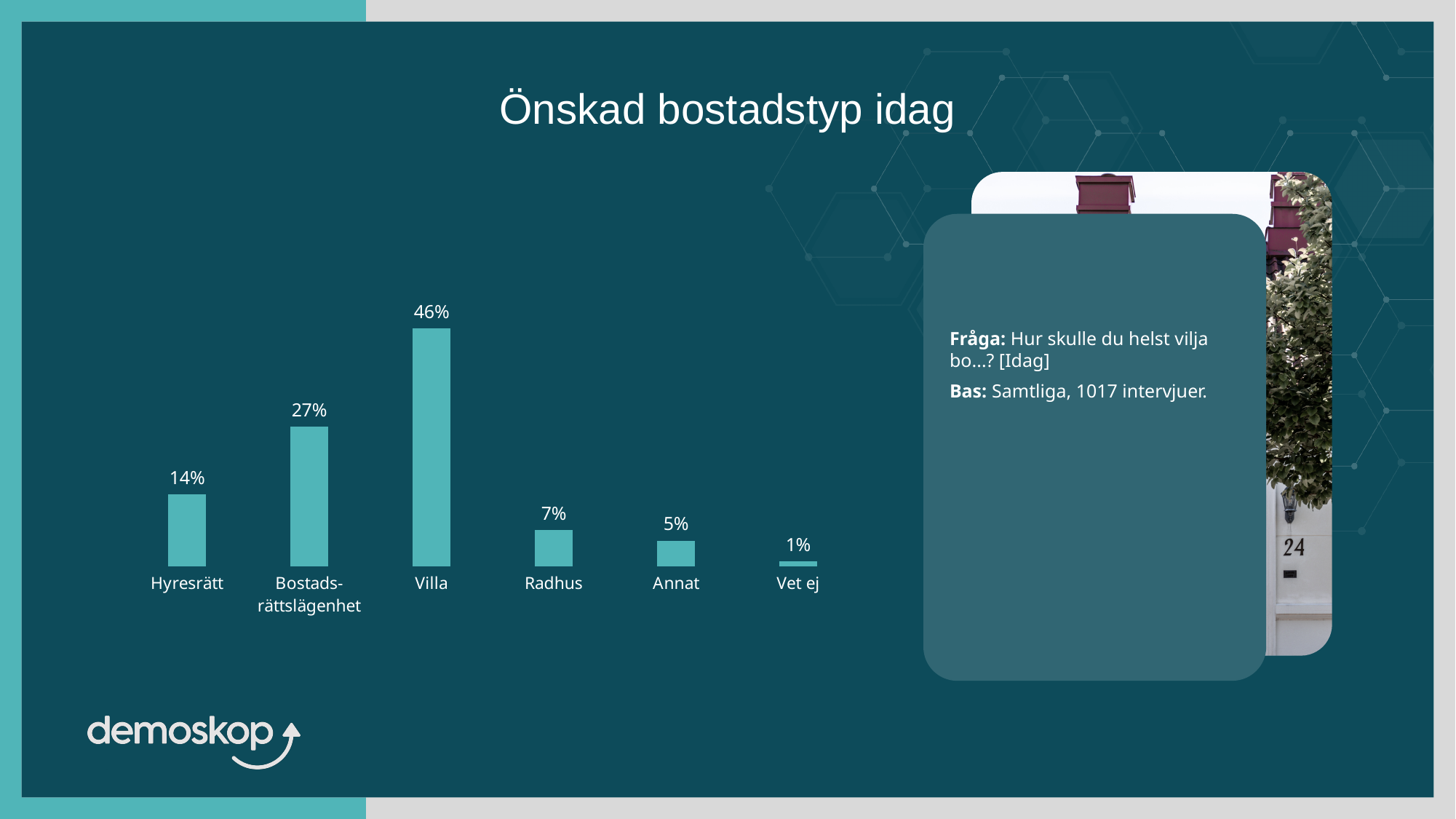
What is the value for Villa? 46% What is the title of the chart? Önskad bostadstyp idag Which category has the highest value? Villa What is the value for Bostadsrättslägenhet? 27% What is the value for Radhus? 7% What is the value for Hyresrätt? 14% Which category has the lowest value? Vet ej How many categories are shown in the chart? 6 What is the difference between the values for Villa and Bostadsrättslägenhet? 19 percentage points Which is larger, the value for Radhus or the value for Annat? Radhus What kind of chart is shown on the slide? Bar chart What is the value for Vet ej? 1%